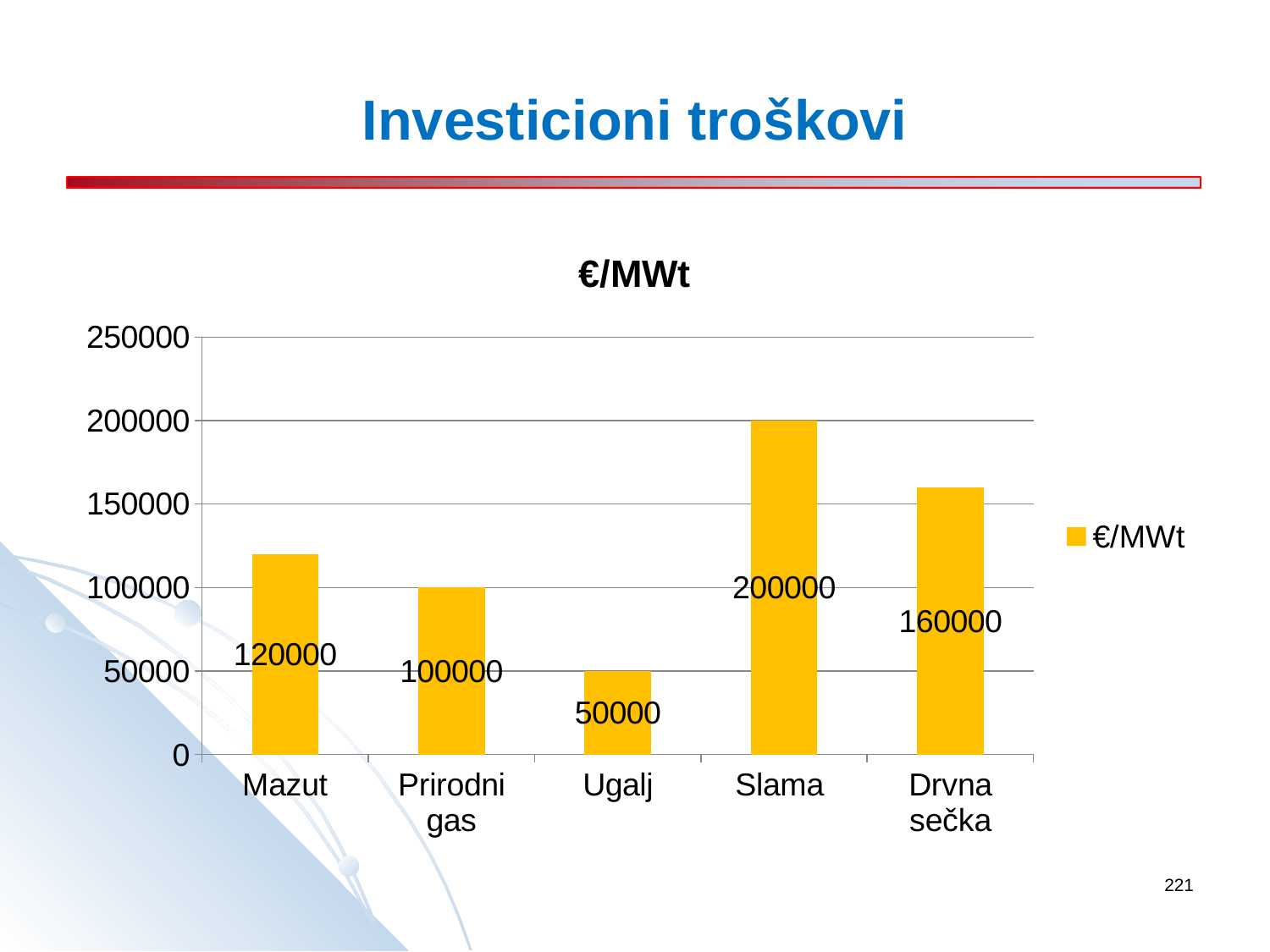
What is the difference between the values for Drvna sečka and Mazut? 40000 How many categories are shown on the x axis? 5 What is the value for Drvna sečka? 160000 Which category has the highest value? Slama What is the difference between the values for Slama and Ugalj? 150000 Which is larger, the value for Mazut or the value for Prirodni gas? Mazut What is the title of the chart? €/MWt What is the value for Prirodni gas? 100000 What is the value for Ugalj? 50000 Which category has the lowest value? Ugalj What is the value for Mazut? 120000 What kind of chart is shown on the slide? Bar chart